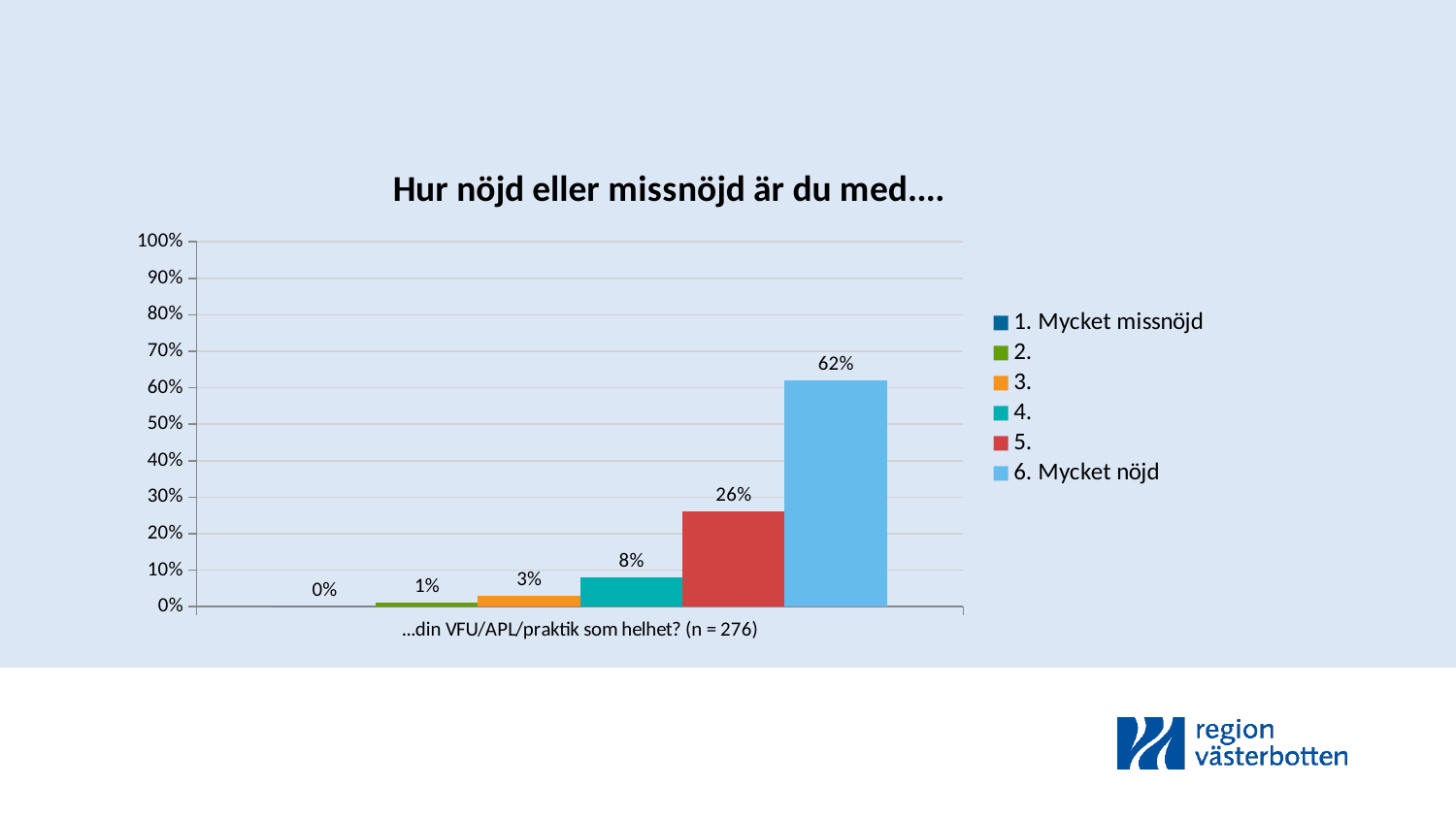
What is the value for "6. Mycket nöjd"? 62% Which series has the lowest value? 1. Mycket missnöjd What kind of chart is shown? bar chart What is the value for "1. Mycket missnöjd"? 0% What is the title of the chart? Hur nöjd eller missnöjd är du med.... Is the value for "6. Mycket nöjd" greater or less than 50%? greater Which is larger, the value for "3." or the value for "4."? 4. What is the value for "5."? 26% What is the difference between the values for "6. Mycket nöjd" and "5."? 36% Which series has the highest value? 6. Mycket nöjd What is the value for "4."? 8% How many series does the legend list? 6